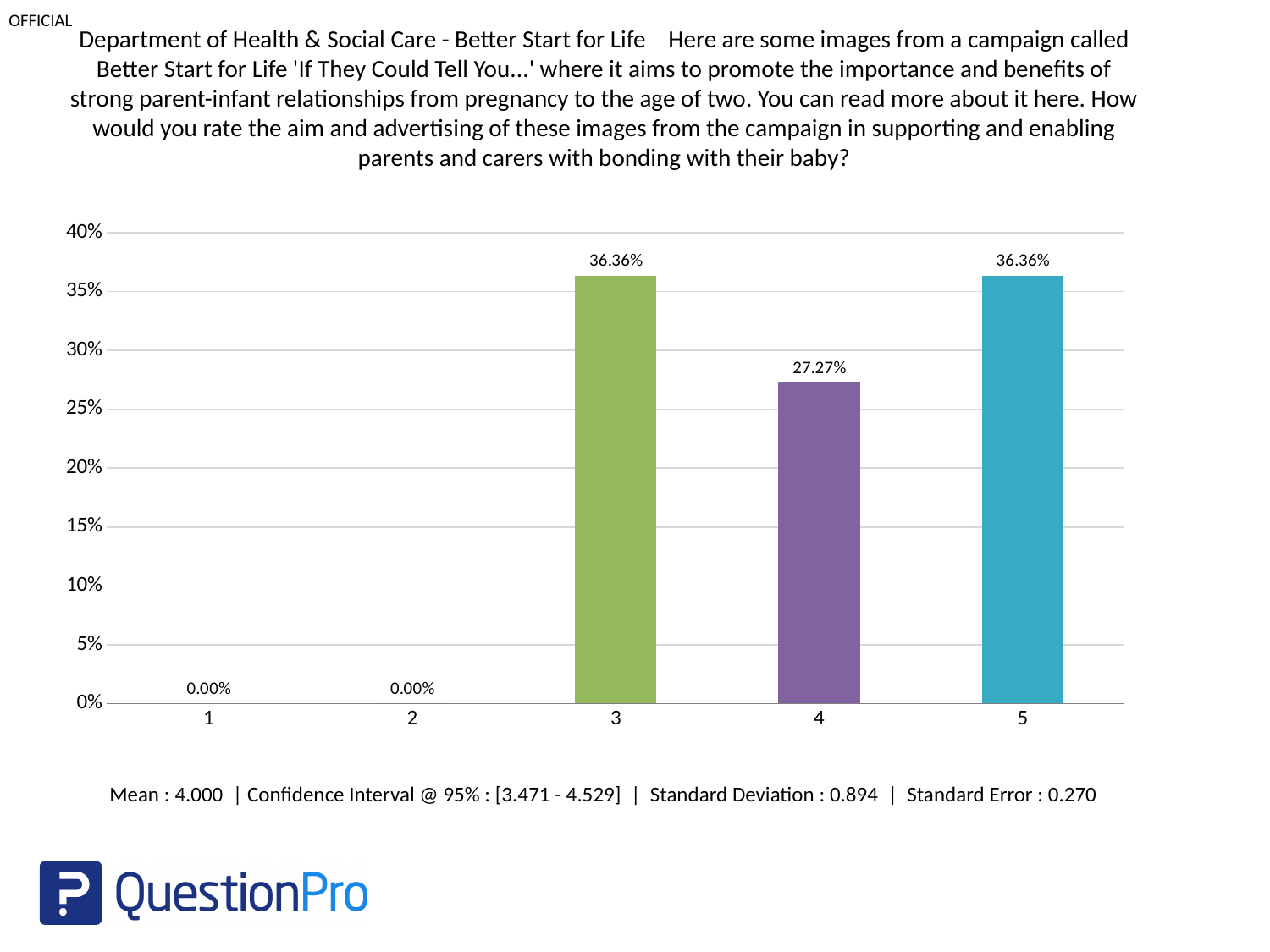
What is the value for rating 4? 27.27% How many rating categories are shown on the x axis? 5 Which rating has the lowest value, 3 or 4? 4 What kind of chart is shown on the slide? bar chart What is the value for rating 3? 36.36% What is the value for rating 5? 36.36% Is the value for rating 4 greater or less than 25%? greater What colour is the bar for rating 4? purple What is the mean value reported below the chart? 4.000 Which is larger, the value for rating 4 or the value for rating 5? 5 What is the difference between the values for rating 3 and rating 4? 9.09% What is the value for rating 1? 0.00%